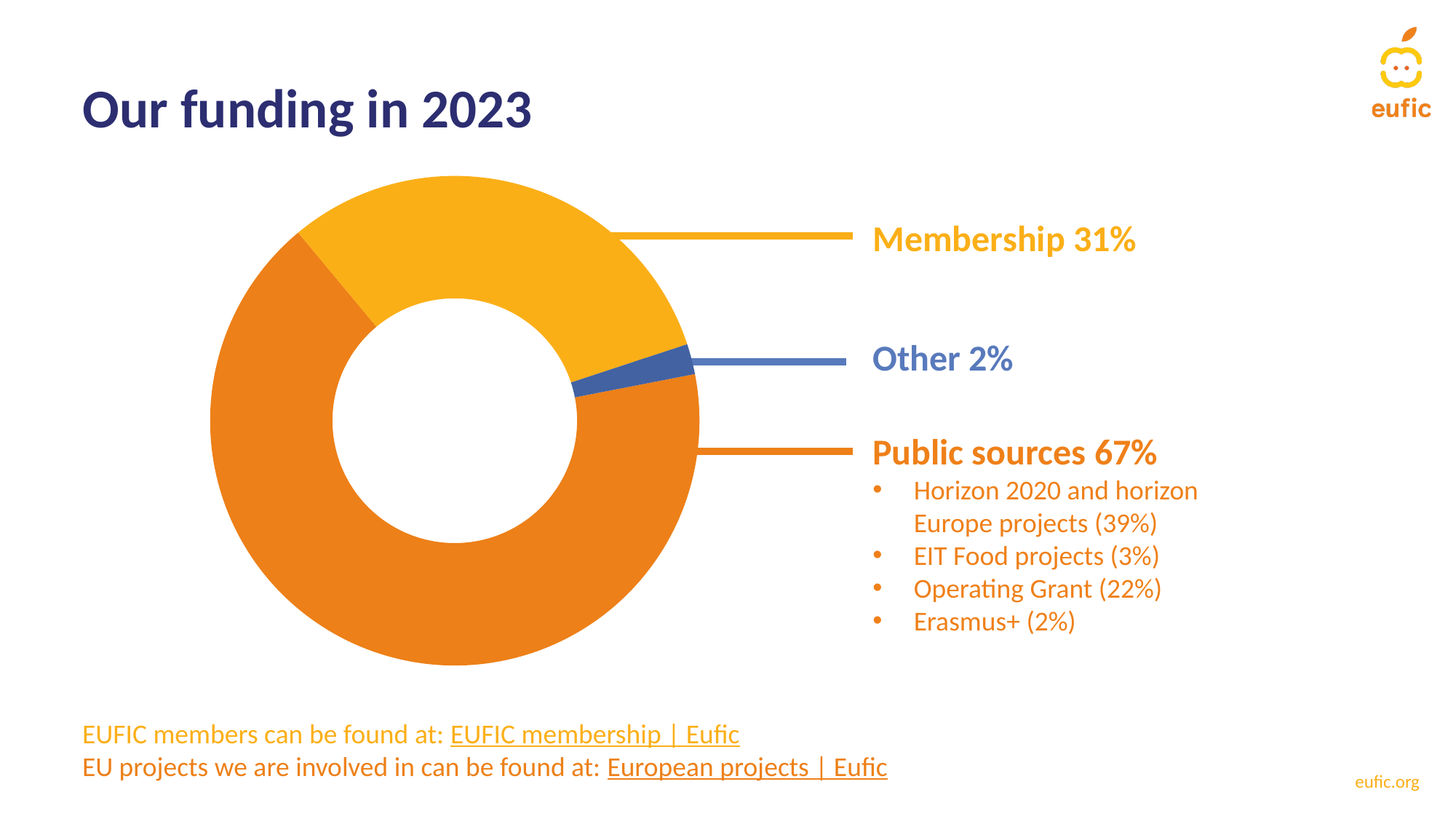
What kind of chart is shown on the slide? Doughnut (pie) chart How many slices does the chart have? 3 What share of funding comes from Membership? 31% What share of funding comes from Other? 2% What is the difference in percentage points between Public sources and Membership? 36 What colour is the Other slice? Blue Which is larger, the Membership share or the Other share? Membership What percentage of funding comes from the Operating Grant within Public sources? 22% What share of funding comes from Public sources? 67% What is the title of the slide? Our funding in 2023 Which funding source has the smallest share? Other Which funding source has the largest share? Public sources